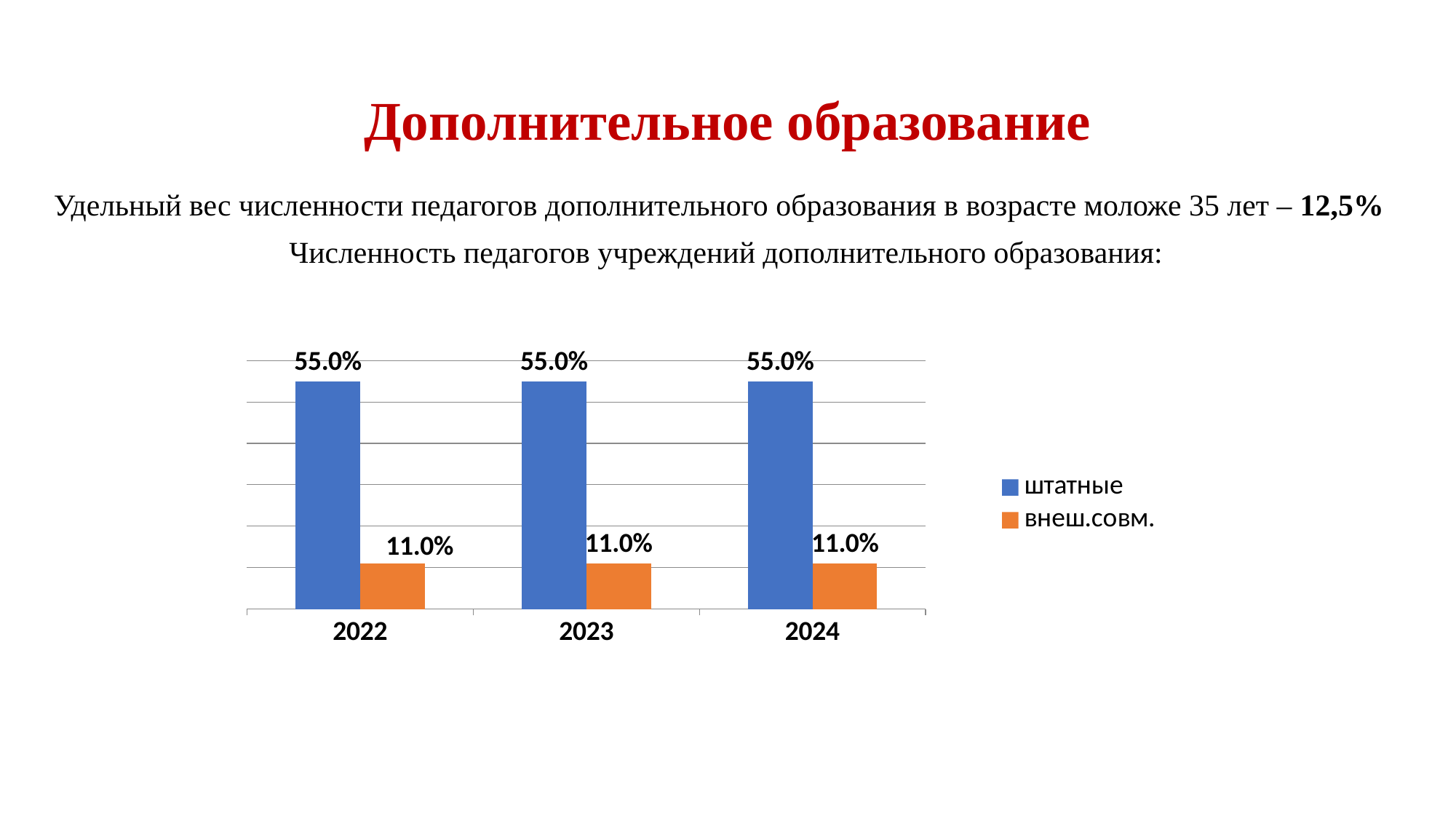
Which series is shown in orange? внеш.совм. What is the value for внеш.совм. in 2023? 11.0% What is the value for штатные in 2022? 55.0% How many series does the legend list? 2 Do the values for штатные rise, fall or stay the same from 2022 to 2024? stay the same What is the value for внеш.совм. in 2022? 11.0% Which is larger in 2024, штатные or внеш.совм.? штатные What is the difference between штатные and внеш.совм. in 2023? 44.0% Which series is shown in blue? штатные How many years are shown on the x axis? 3 What is the value for штатные in 2024? 55.0% What kind of chart is shown on the slide? bar chart